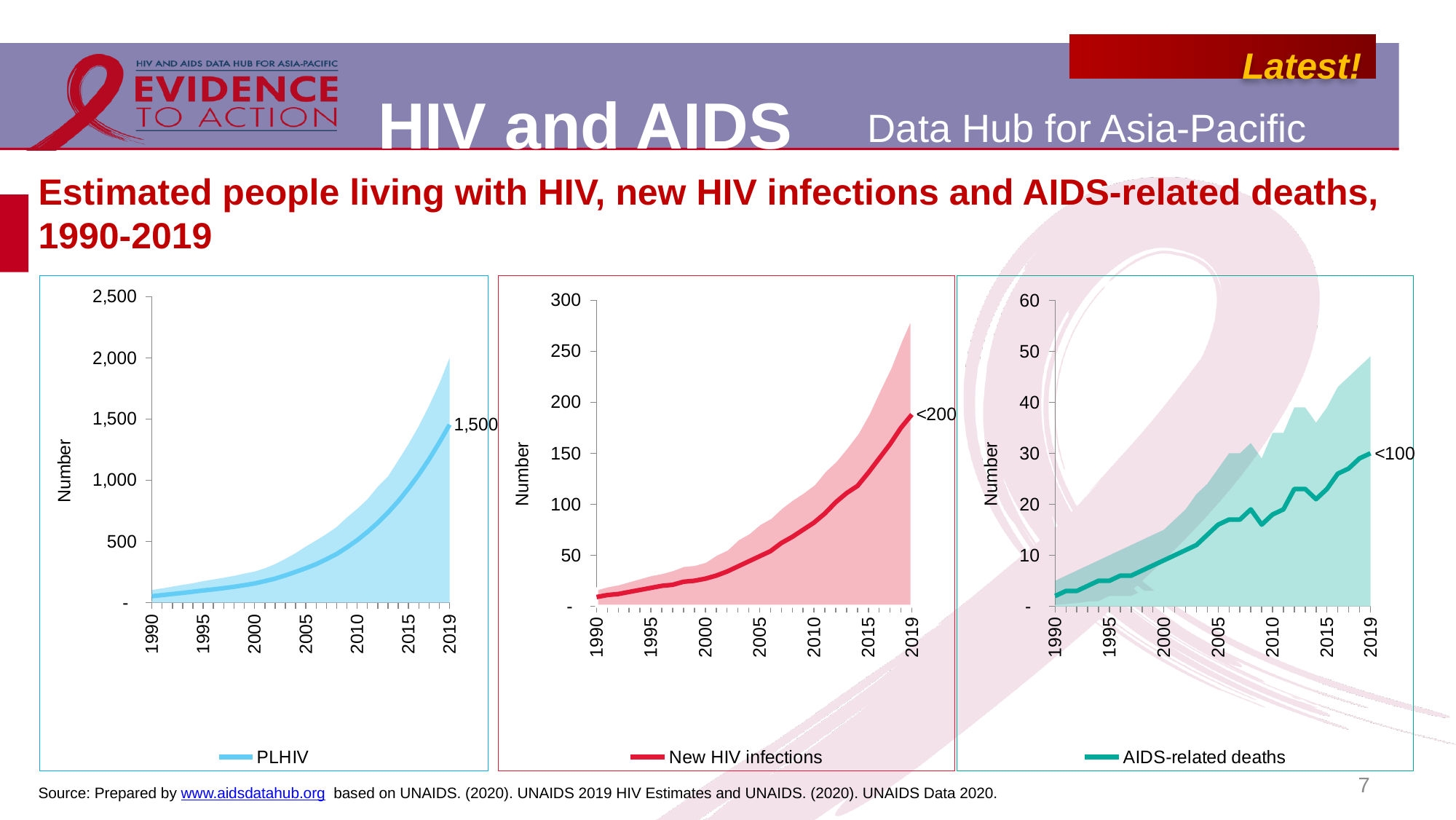
What kind of chart is the AIDS-related deaths chart on the right? line chart In the PLHIV chart on the left, what value is labelled at the end of the line in 2019? 1,500 In the New HIV infections chart in the middle, does the line rise or fall from 1990 to 2019? rise In the New HIV infections chart in the middle, is the value for 2015 greater or less than 100? greater How many series does the legend of the New HIV infections chart in the middle list? 1 In the PLHIV chart on the left, does the line rise or fall from 1990 to 2019? rise In the PLHIV chart on the left, is the value for 2000 greater or less than 500? less In the PLHIV chart on the left, which year has the highest value, 1990 or 2019? 2019 In the New HIV infections chart in the middle, what value is labelled at the end of the line in 2019? <200 In the AIDS-related deaths chart on the right, is the value for 2019 greater or less than 20? greater In the AIDS-related deaths chart on the right, what value is labelled at the end of the line in 2019? <100 What is the legend entry of the chart on the left? PLHIV